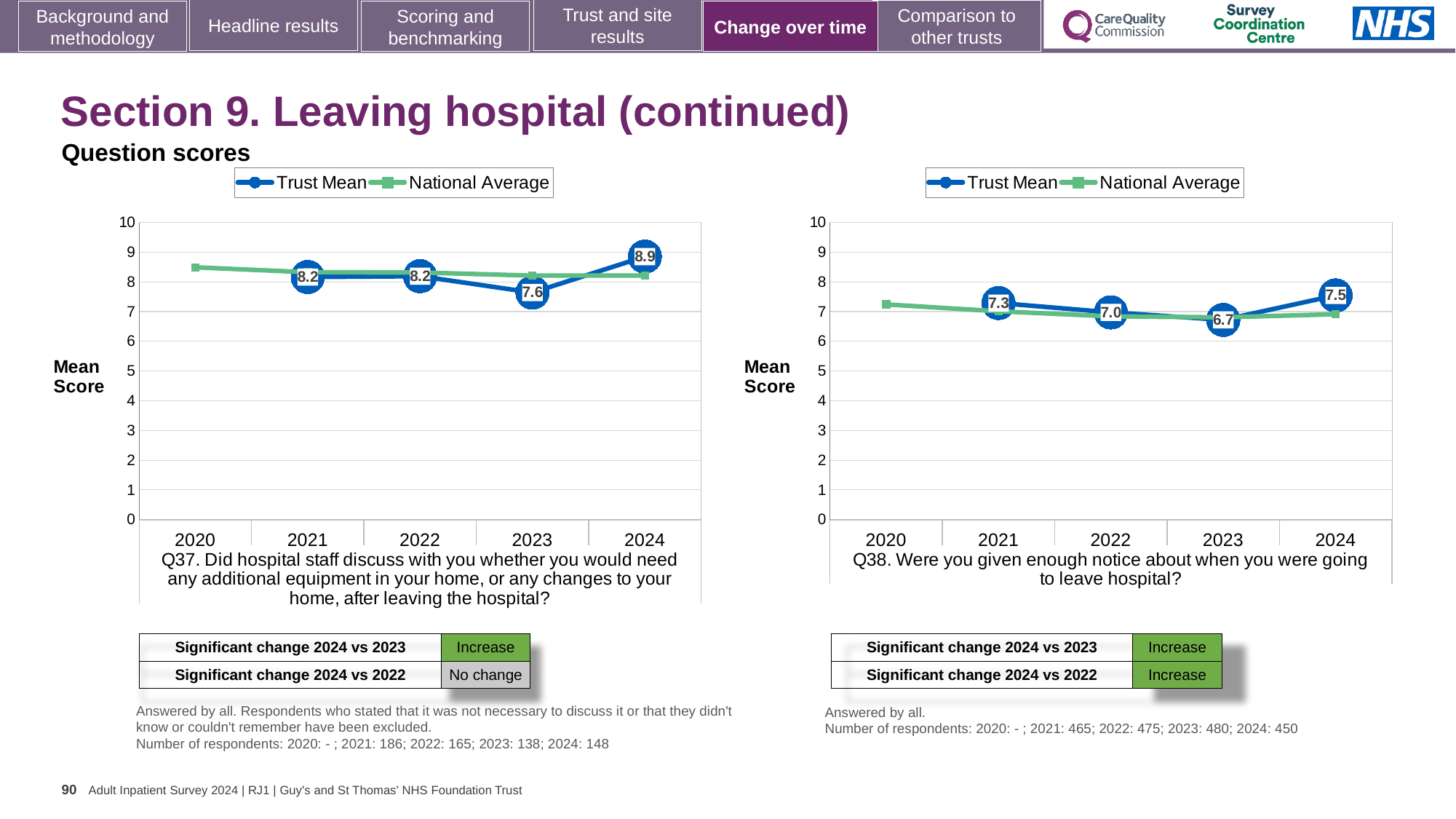
In the Q37 chart, what is the difference between the Trust Mean scores for 2024 and 2023? 1.3 In the Q38 chart, is the Trust Mean score higher in 2021 or in 2022? 2021 In the Q38 chart, which year has the lowest Trust Mean score? 2023 In the Q38 chart, what is the Trust Mean score for 2024? 7.5 In the Q37 chart, which year has the highest Trust Mean score? 2024 In the Q37 chart, what is the Trust Mean score for 2024? 8.9 In the Q37 chart, is the National Average value for 2020 greater or less than 8? greater In the Q37 chart, what is the Trust Mean score for 2023? 7.6 What kind of chart is used for Q37? Line chart In the Q38 chart, what is the Trust Mean score for 2022? 7.0 How many series does the legend of the Q38 chart list? 2 In the Q38 chart, what is the difference between the Trust Mean scores for 2021 and 2023? 0.6